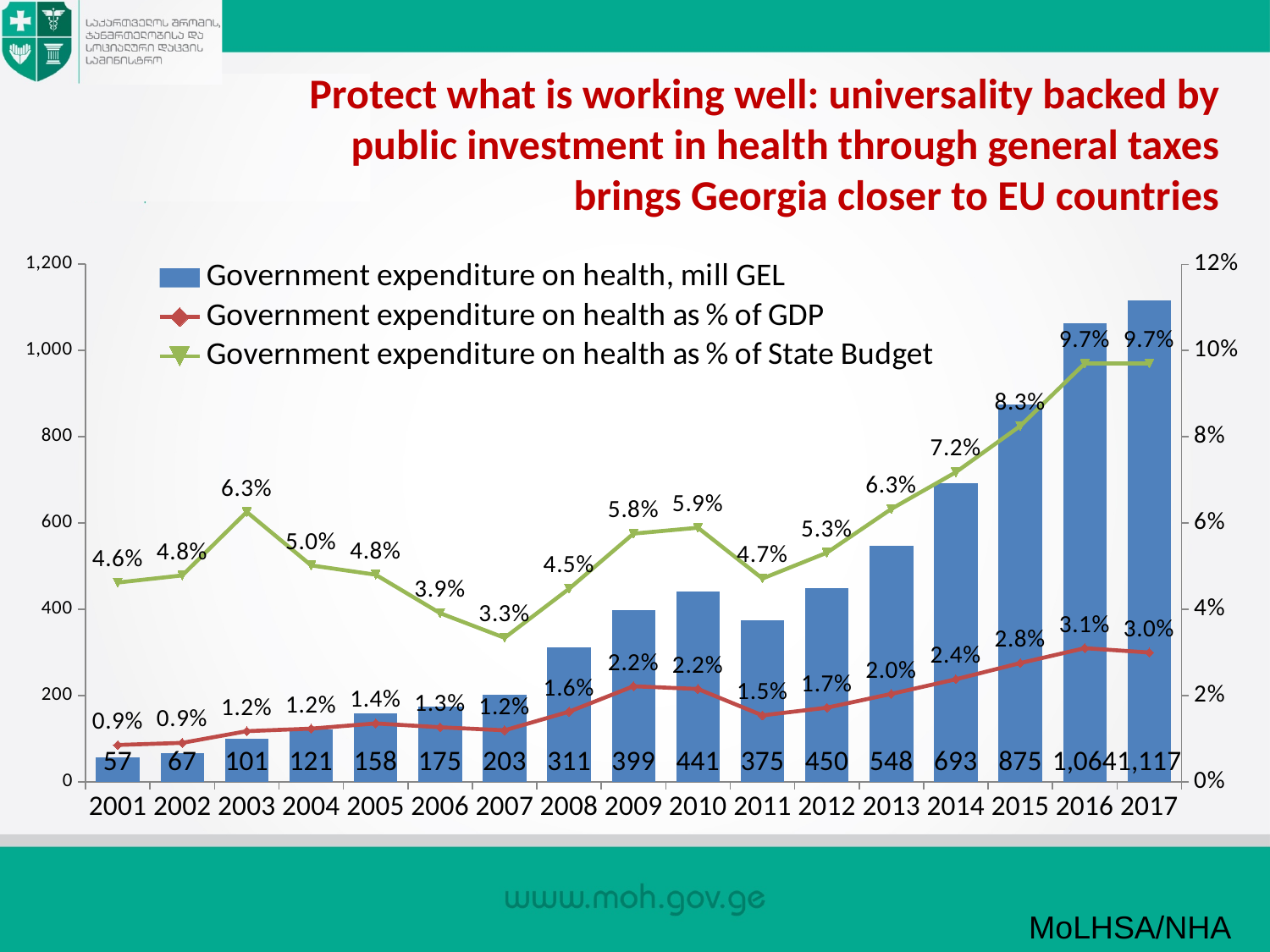
Does government expenditure on health as % of State Budget rise or fall from 2013 to 2016? Rise Which year had higher government expenditure on health in mill GEL, 2010 or 2011? 2010 How many years are shown on the x axis of the chart? 17 Which series is shown with green triangle markers? Government expenditure on health as % of State Budget In which year was government expenditure on health in mill GEL the highest? 2017 What was government expenditure on health as % of GDP in 2014? 2.4% What was government expenditure on health in mill GEL in 2009? 399 How many series does the legend list? 3 In which year was government expenditure on health as % of State Budget the lowest? 2007 What is the difference in government expenditure on health in mill GEL between 2017 and 2016? 53 What kind of chart is used to show government expenditure on health in mill GEL? Bar chart What was government expenditure on health as % of State Budget in 2007? 3.3%